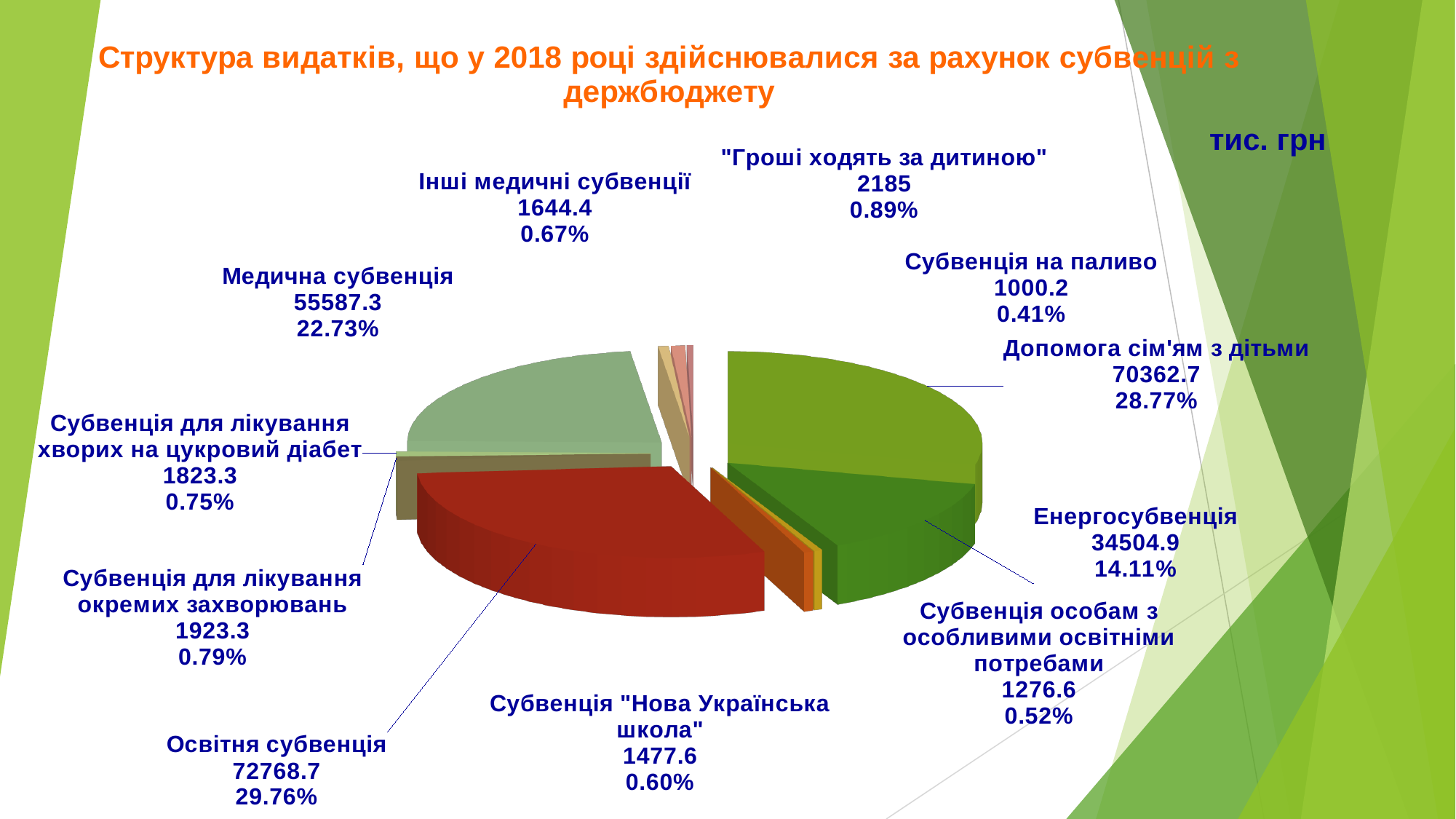
What is the difference between the values for Освітня субвенція and Допомога сім'ям з дітьми? 2406 What percentage is shown for Медична субвенція? 22.73% How many categories are shown in the pie chart? 11 Which is larger: Медична субвенція or Енергосубвенція? Медична субвенція What is the value for Енергосубвенція? 34504.9 What unit is indicated for the values on the chart? тис. грн What share of the pie does Допомога сім'ям з дітьми represent? 28.77% What is the value for Субвенція "Нова Українська школа"? 1477.6 Which category has the largest share of the pie? Освітня субвенція What kind of chart is shown on the slide? pie chart What is the value for Освітня субвенція? 72768.7 Which category has the smallest share of the pie? Субвенція на паливо